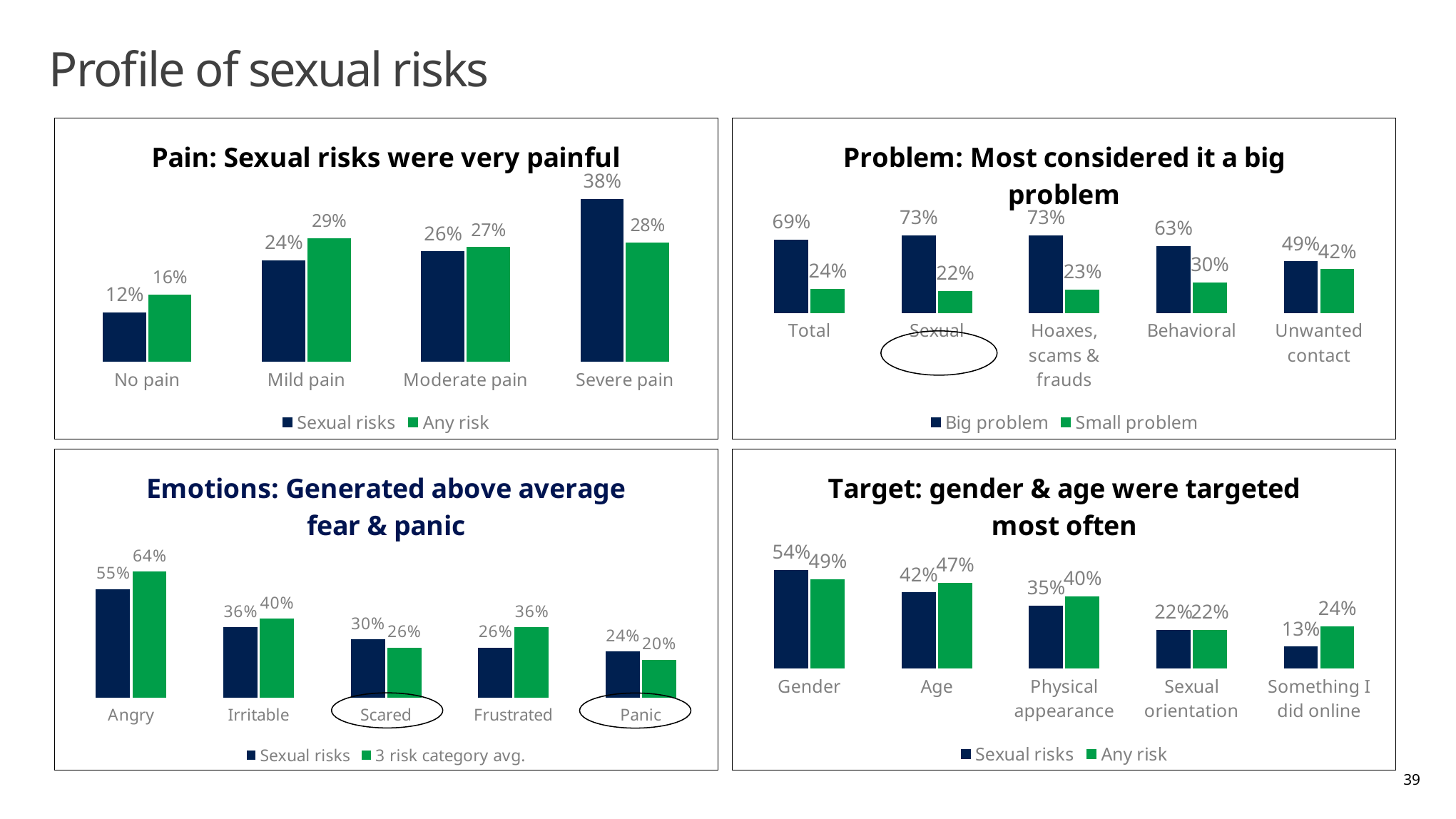
In the 'Problem: Most considered it a big problem' chart, how many categories are shown on the x axis? 5 In the 'Pain: Sexual risks were very painful' chart, which pain category has the lowest Sexual risks value? No pain In the 'Problem: Most considered it a big problem' chart, what is the Big problem value for Behavioral? 63% In the 'Pain: Sexual risks were very painful' chart, what is the Sexual risks value for Severe pain? 38% In the 'Target: gender & age were targeted most often' chart, how many series does the legend list? 2 In the 'Emotions: Generated above average fear & panic' chart, which is larger for Scared: Sexual risks or 3 risk category avg.? Sexual risks In the 'Emotions: Generated above average fear & panic' chart, which emotion has the highest Sexual risks value? Angry What type of chart is the 'Target: gender & age were targeted most often' chart? Bar chart In the 'Emotions: Generated above average fear & panic' chart, what is the 3 risk category avg. value for Angry? 64% In the 'Target: gender & age were targeted most often' chart, what is the Sexual risks value for Something I did online? 13% In the 'Pain: Sexual risks were very painful' chart, what is the difference between the Any risk and Sexual risks values for Mild pain? 5% In the 'Problem: Most considered it a big problem' chart, what is the difference between the Big problem and Small problem values for Sexual? 51%